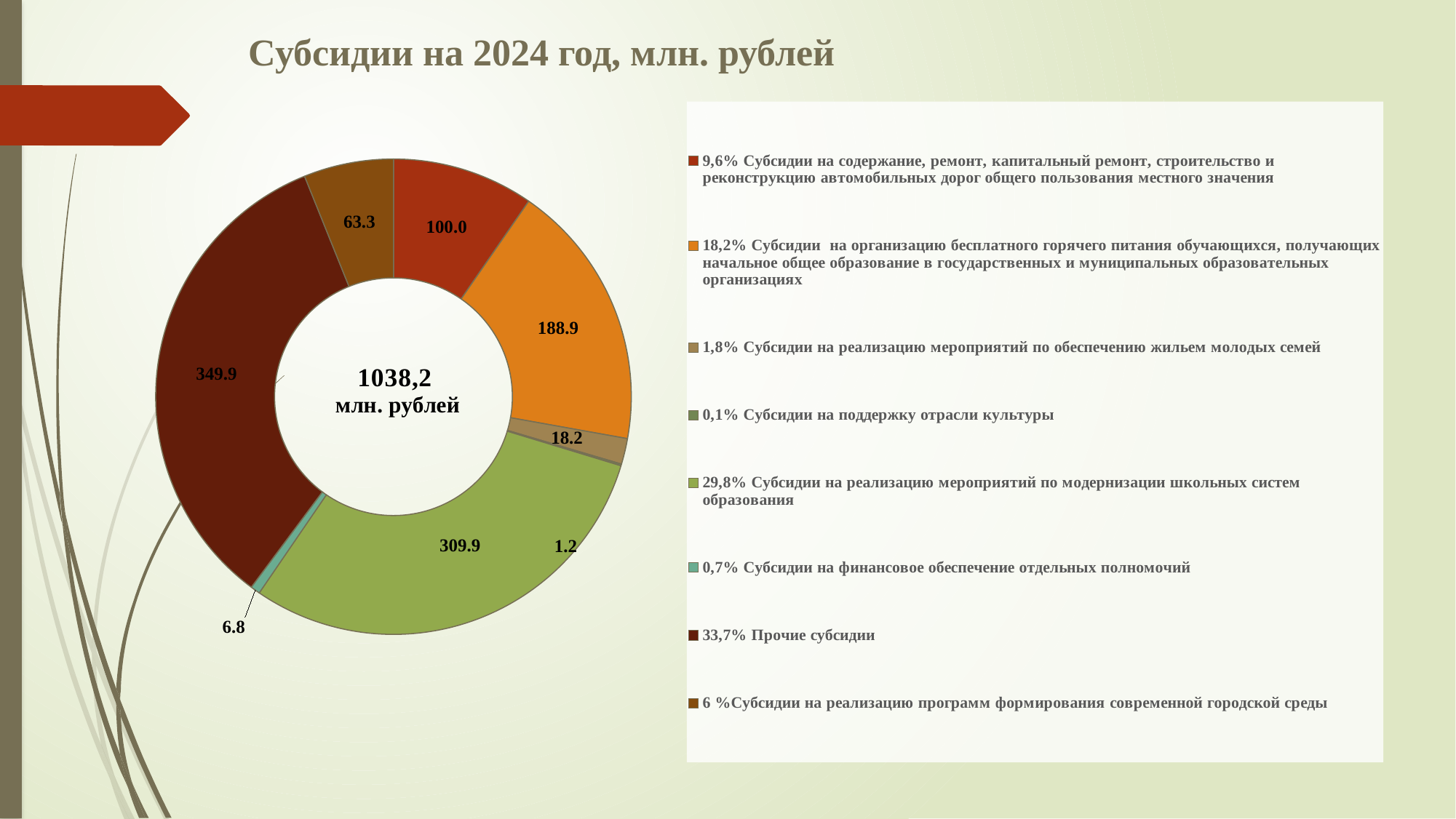
What total is shown in the centre of the doughnut chart? 1038,2 млн. рублей Which category has the smallest value? Субсидии на поддержку отрасли культуры Which is larger: the value for road subsidies ("Субсидии на содержание, ремонт, капитальный ремонт... автомобильных дорог") or the value for urban environment programs ("Субсидии на реализацию программ формирования современной городской среды")? road subsidies (100.0) What is the value for subsidies for free hot meals for primary school students ("Субсидии на организацию бесплатного горячего питания обучающихся...")? 188.9 What is the value for subsidies for modernization of school education systems ("Субсидии на реализацию мероприятий по модернизации школьных систем образования")? 309.9 How many categories does the chart show? 8 What is the value for "Прочие субсидии"? 349.9 Which category has the largest value? Прочие субсидии What share of the total do subsidies for modernization of school education systems represent, according to the legend? 29,8% What type of chart is shown on the slide? doughnut chart What is the value for subsidies for housing for young families ("Субсидии на реализацию мероприятий по обеспечению жильем молодых семей")? 18.2 What is the difference between the value for "Прочие субсидии" and the value for subsidies for modernization of school education systems? 40.0